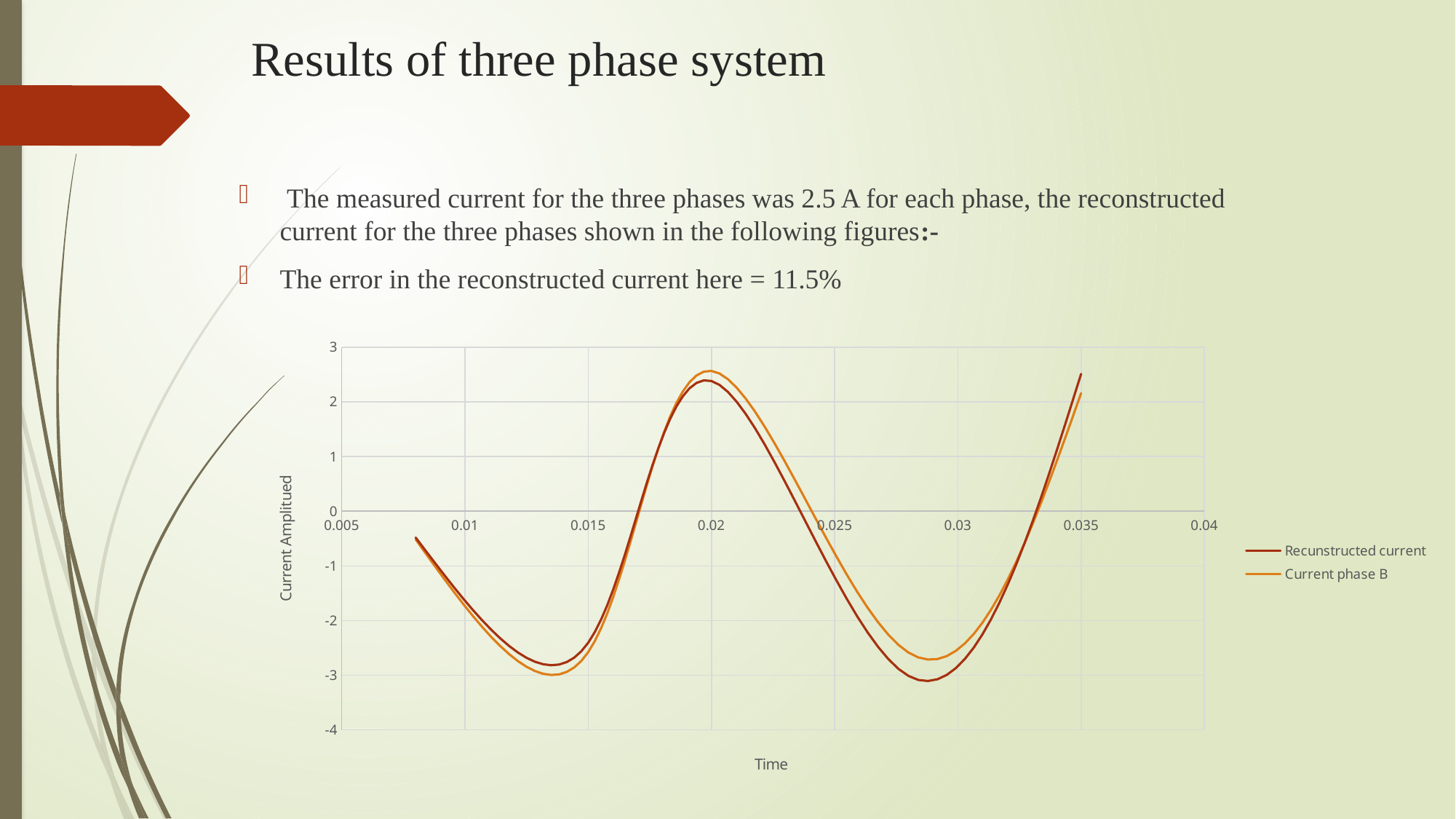
At the trough near time 0.029, which series reaches the lower value, Reconstructed current or Current phase B? Reconstructed current Between time 0.02 and time 0.025, do the values of the Current phase B series rise or fall? fall Between time 0.015 and time 0.02, do the values of the Reconstructed current series rise or fall? rise At the peak near time 0.02, which series reaches the higher value, Reconstructed current or Current phase B? Current phase B What are the two series named in the chart legend? Recunstructed current and Current phase B Is the lowest value of the Reconstructed current series near time 0.03 greater or less than -2? less Is the value of the Current phase B series at time 0.015 greater or less than -1? less Is the value of the Reconstructed current series at time 0.025 greater or less than 0? less What kind of chart is shown on the slide? Line chart What is the title of the chart's vertical axis? Current Amplitued How many series does the chart legend list? 2